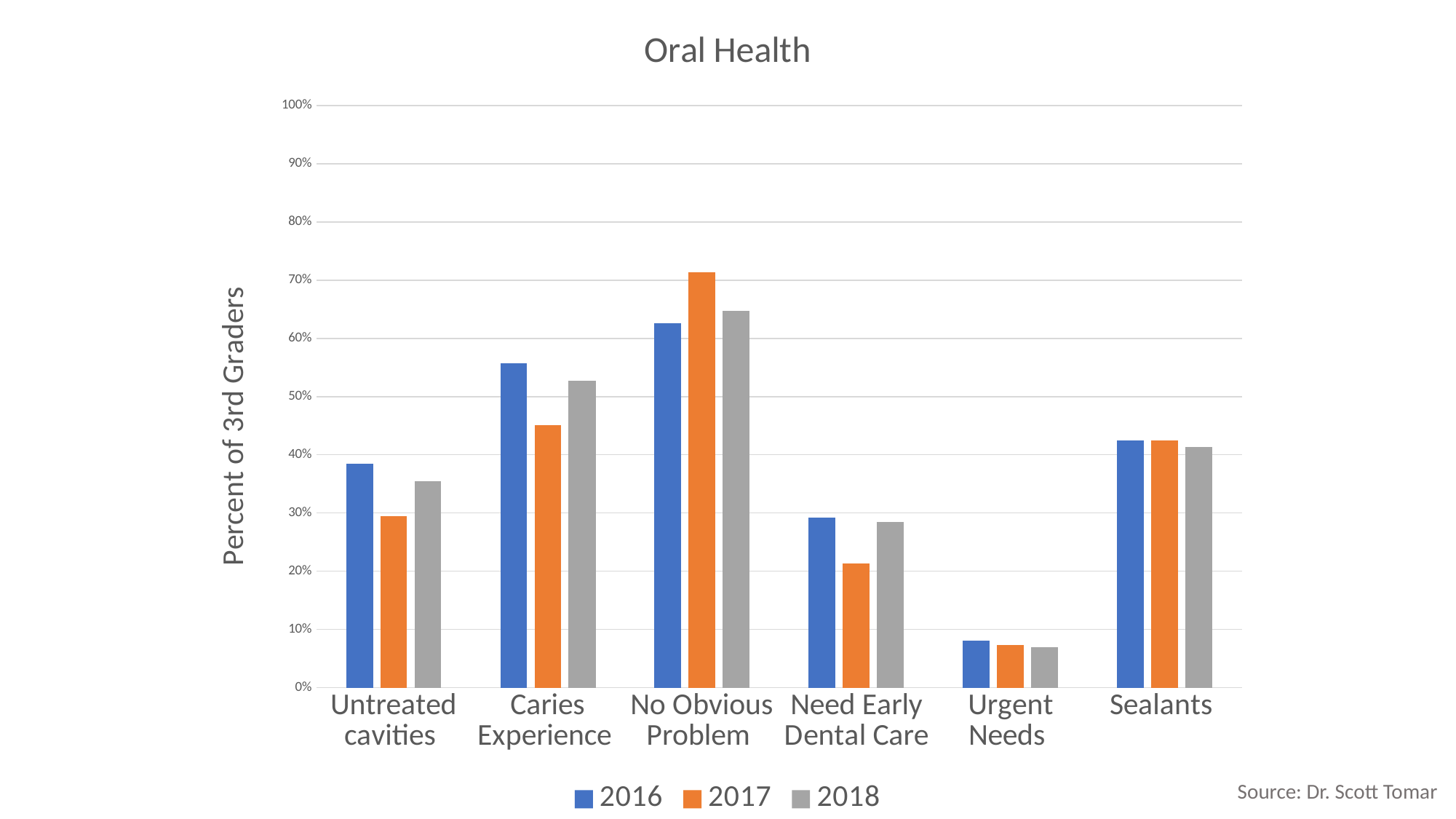
How many series does the legend list? 3 How many categories are shown on the x axis? 6 Is the 2016 value for Caries Experience greater or less than 50%? greater Is the 2017 value for Caries Experience greater or less than 50%? less For Untreated cavities, which is larger: the 2016 value or the 2017 value? 2016 What is the title of the y axis? Percent of 3rd Graders For No Obvious Problem, which is larger: the 2017 value or the 2018 value? 2017 Which category has the highest value for 2017? No Obvious Problem For Caries Experience, which year has the lowest value? 2017 Is the 2017 value for No Obvious Problem greater or less than 70%? greater What kind of chart is shown on the slide? bar chart Which category has the lowest value for 2016? Urgent Needs